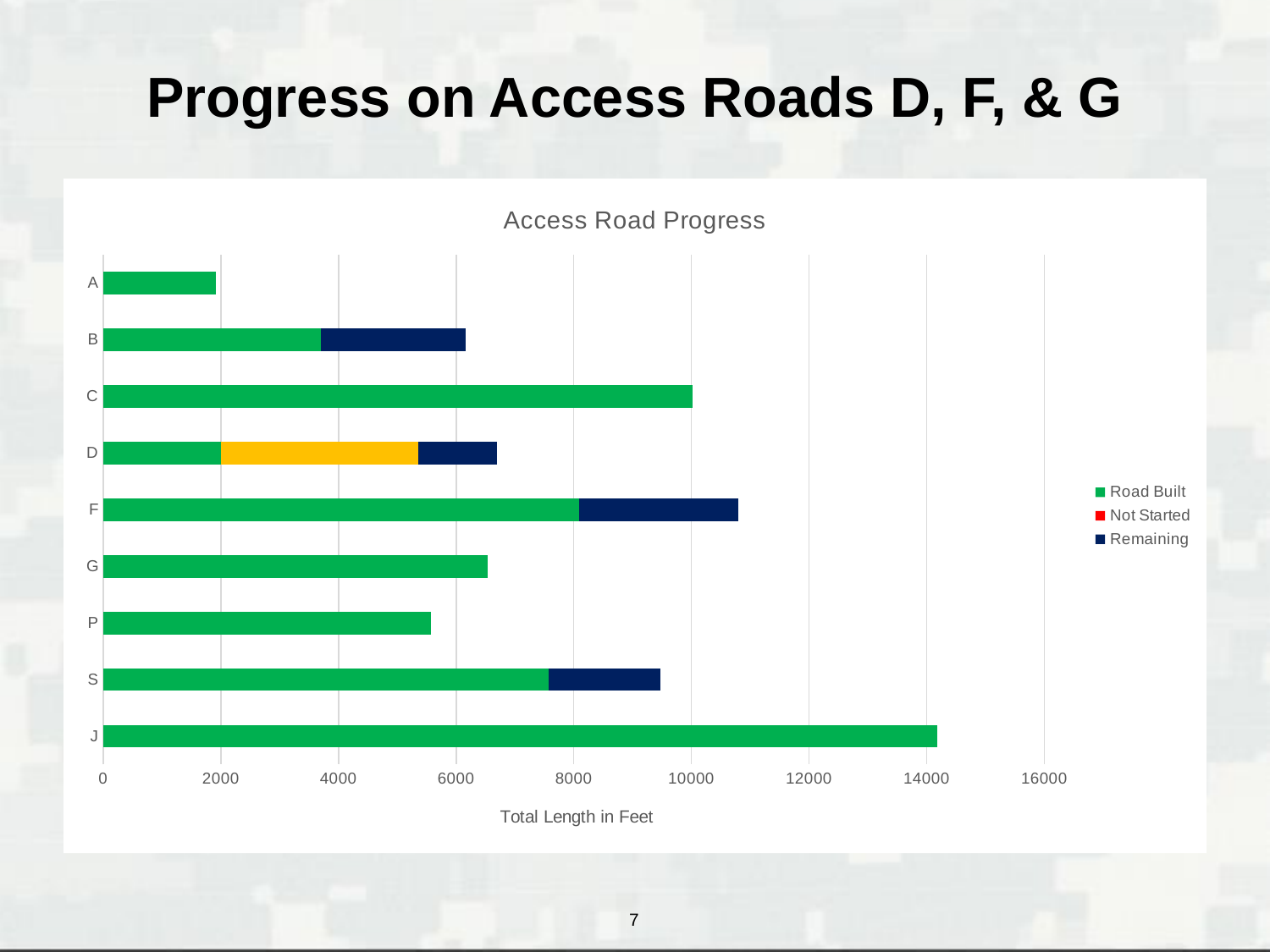
Is the total length for road J greater or less than 12000? greater What is the label on the horizontal axis? Total Length in Feet Is the total length for road F greater or less than 10000? greater Which access road has the shortest total bar? A What kind of chart is shown on the slide? bar chart How many series does the legend list? 3 Which has the larger total length, road C or road G? C What is the title of the chart? Access Road Progress How many access roads (categories) are plotted on the chart? 9 Is the total length for road P greater or less than 6000? less Which access road has the longest total bar? J